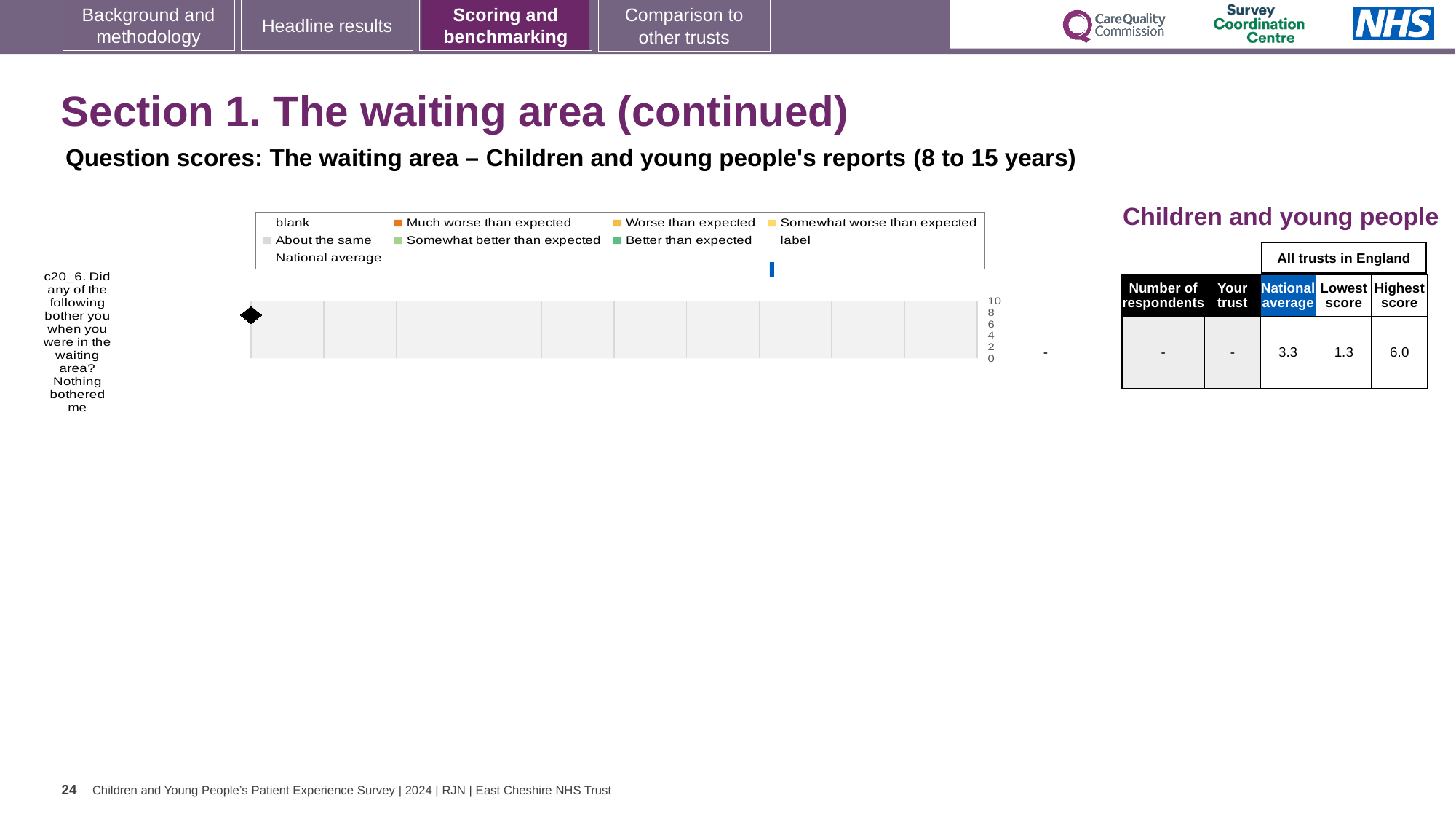
What colour does the legend use for 'Much worse than expected'? orange Which survey question is plotted on the chart? c20_6. Did any of the following bother you when you were in the waiting area? Nothing bothered me In the table, what is the difference between the Highest score and the Lowest score for question c20_6? 4.7 What is the highest value shown on the chart's axis? 10 In the 'All trusts in England' table, what is the National average score for question c20_6? 3.3 How many survey questions (categories) are plotted on the chart? 1 In the table, is the National average score for question c20_6 greater or less than 5? less In the 'All trusts in England' table, what is the Highest score for question c20_6? 6.0 What kind of chart is shown on the slide? bar chart In the 'All trusts in England' table, what is the Lowest score for question c20_6? 1.3 In the table, what value is shown for 'Your trust' for question c20_6? - How many entries does the chart legend list? 9